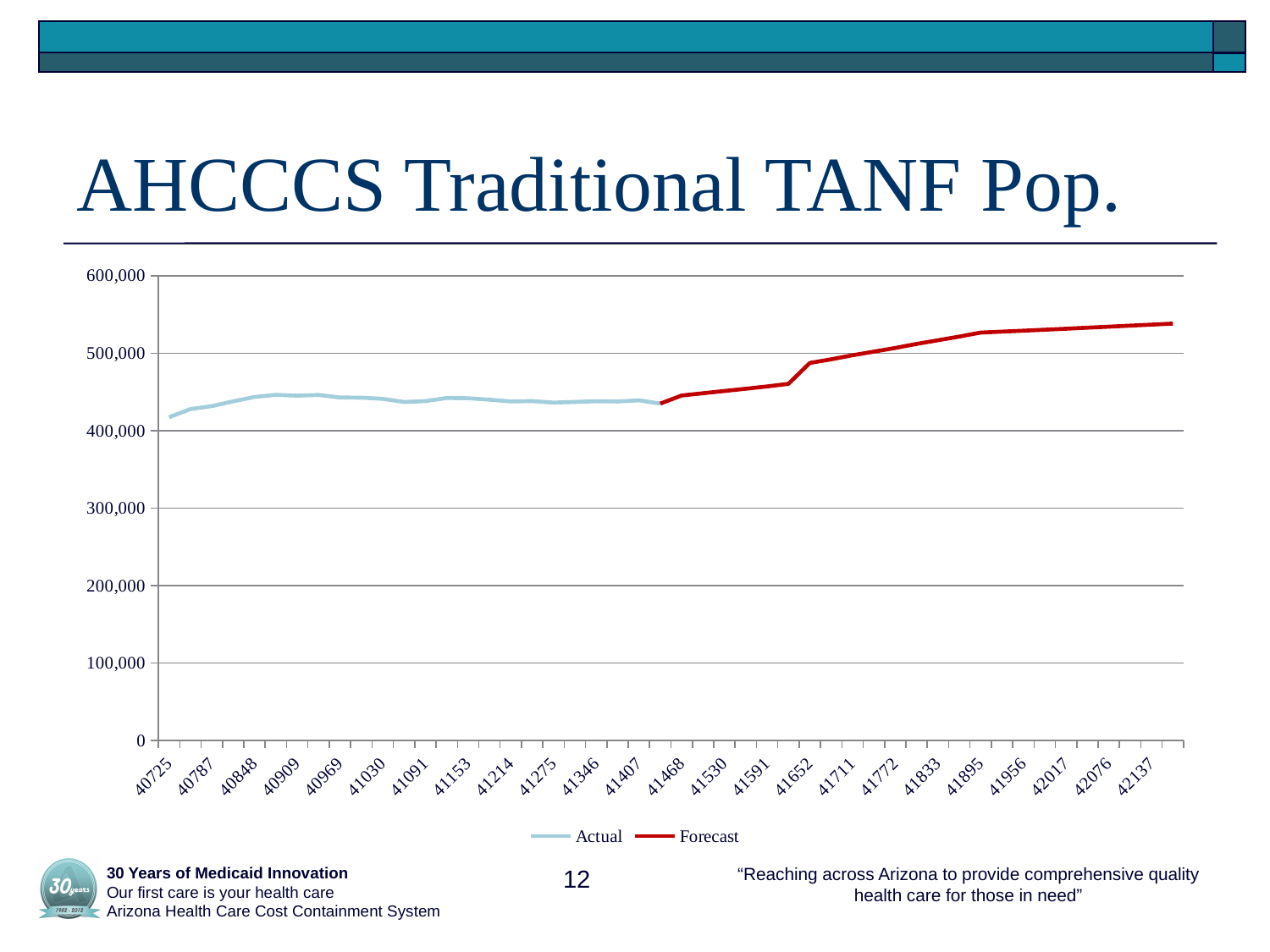
How many labels are shown on the x axis? 24 Is the Forecast value at 42137 greater or less than 500,000? greater Which is larger, the Forecast value at 42137 or the Actual value at 40725? Forecast value at 42137 What kind of chart is shown on the slide? line chart Is the Forecast value at 41652 greater or less than 400,000? greater What are the two series named in the legend? Actual and Forecast Which series is drawn in red? Forecast Is the Actual value at 40725 greater or less than 400,000? greater Does the Forecast series rise or fall along the x axis? rise How many series does the legend list? 2